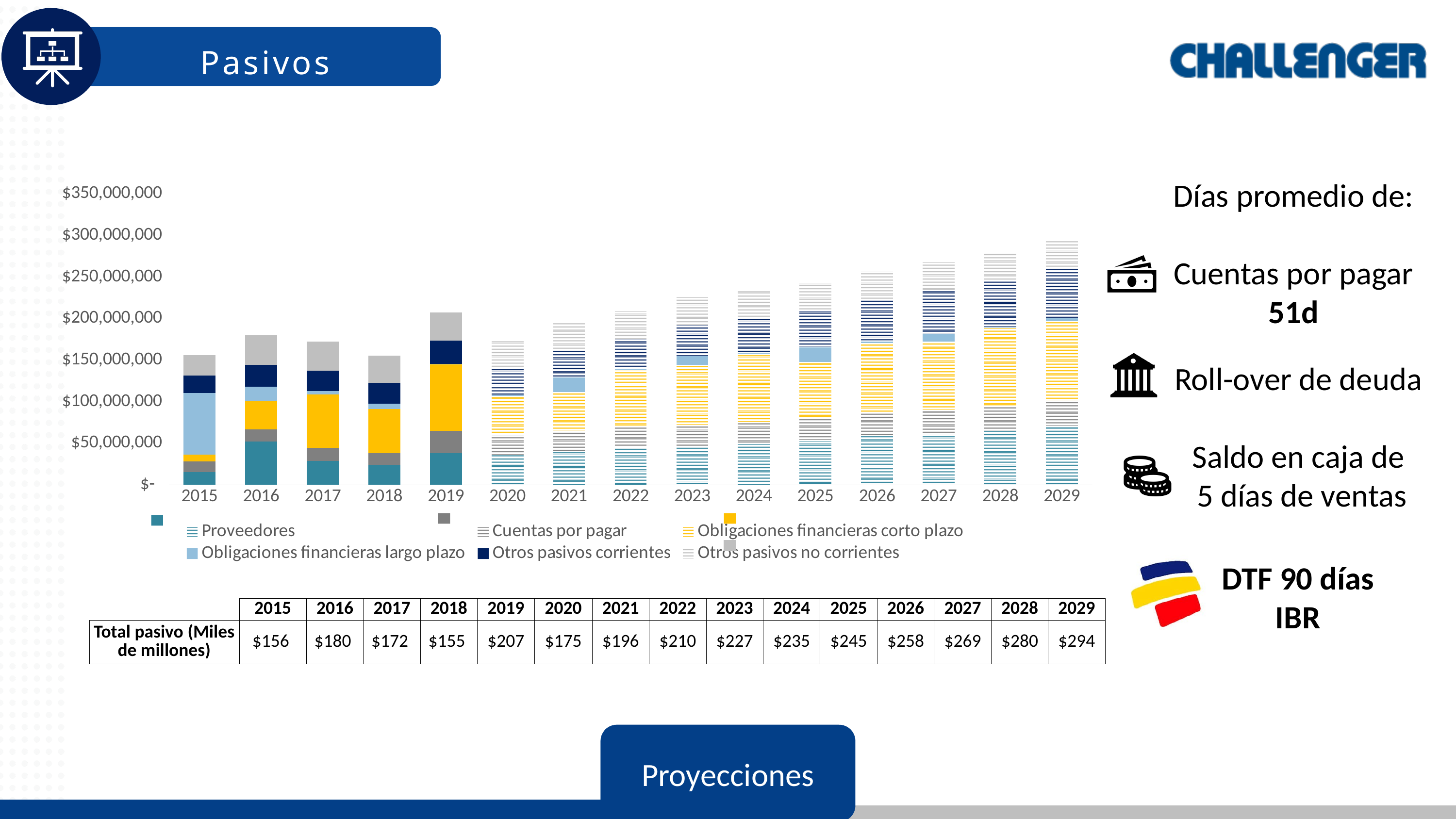
Using the table values, what is the difference in Total pasivo between 2029 and 2015? $138 What type of chart is shown on the slide? Stacked bar chart Which year has the tallest stacked bar in the chart? 2029 How many years (categories) are shown on the x axis of the chart? 15 Which year has a larger total pasivo, 2019 or 2020? 2019 How many series does the chart legend list? 6 Is the total value of the 2029 bar greater or less than $300,000,000? less Is the total value of the 2020 bar greater or less than $150,000,000? greater According to the table below the chart, what is the Total pasivo (Miles de millones) for 2019? $207 Do the stacked bar totals rise or fall from 2020 to 2029? Rise According to the table below the chart, what is the Total pasivo (Miles de millones) for 2029? $294 Is the total value of the 2019 bar greater or less than $200,000,000? greater